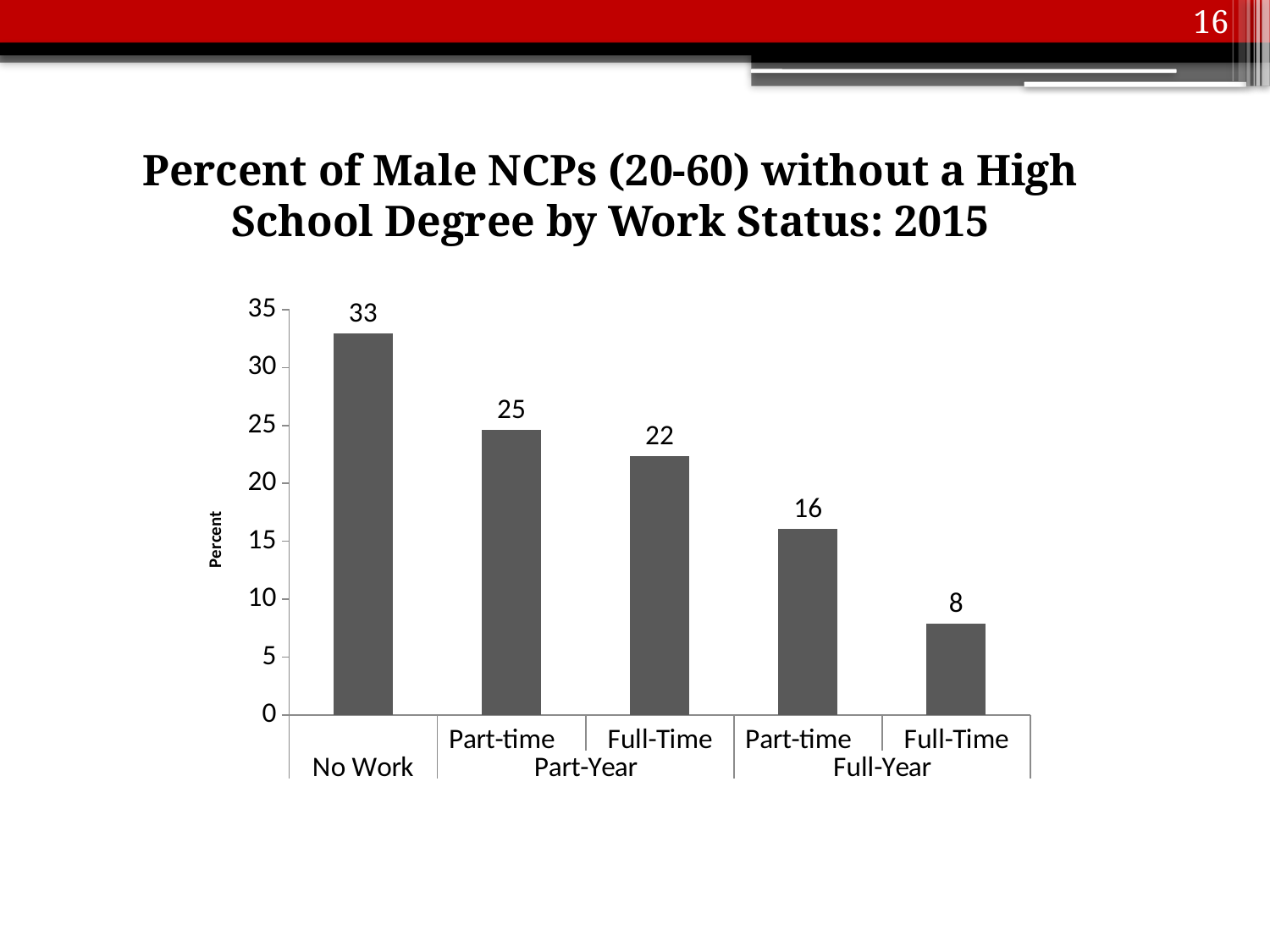
What kind of chart is shown on the slide? Bar chart Which is larger: the Part-Year Part-time value or the Full-Year Part-time value? Part-Year Part-time Which category has the highest percentage? No Work What is the value for Part-time workers in the Part-Year group? 25 What is the value for No Work? 33 What is the difference between the No Work value and the Full-Year Full-Time value? 25 What is the difference between the Part-Year Full-Time value and the Full-Year Part-time value? 6 Which category has the lowest percentage? Full-Year Full-Time What is the value for Full-Time workers in the Full-Year group? 8 Do the values rise or fall moving from left to right across the categories? Fall How many bars are shown in the chart? 5 What is the label on the vertical axis? Percent